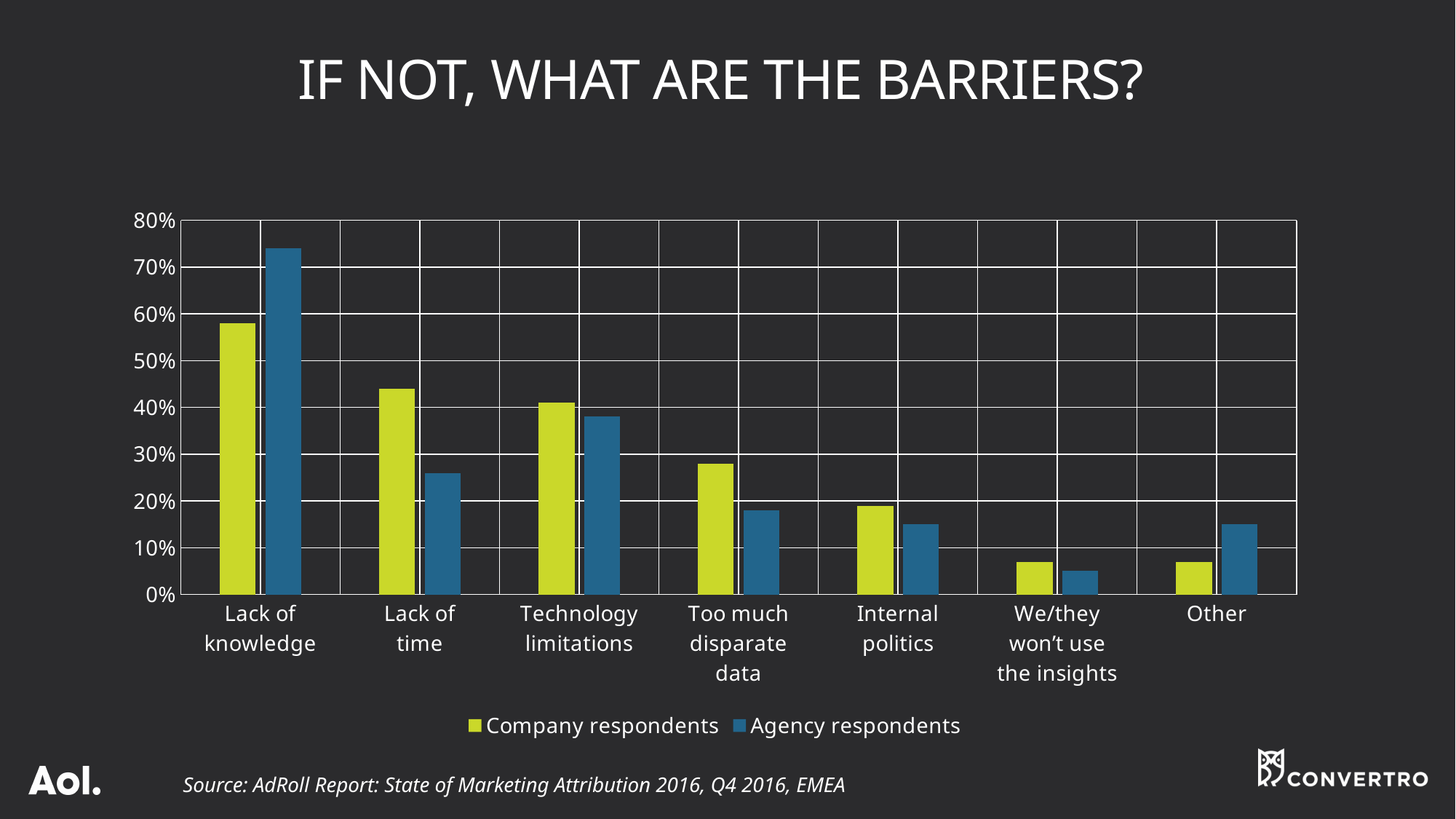
Is the Company respondents value for Lack of time greater or less than 40%? greater Which barrier has the lowest value for Agency respondents? We/they won't use the insights Which barrier has the highest value for Company respondents? Lack of knowledge For Lack of knowledge, which is larger: Company respondents or Agency respondents? Agency respondents How many series does the legend list? 2 How many barrier categories are shown on the x axis? 7 What kind of chart is shown on the slide? Bar chart Is the Agency respondents value for Lack of time greater or less than 30%? less Is the Company respondents value for Other greater or less than 10%? less Which barrier has the highest value for Agency respondents? Lack of knowledge For Other, which is larger: Company respondents or Agency respondents? Agency respondents